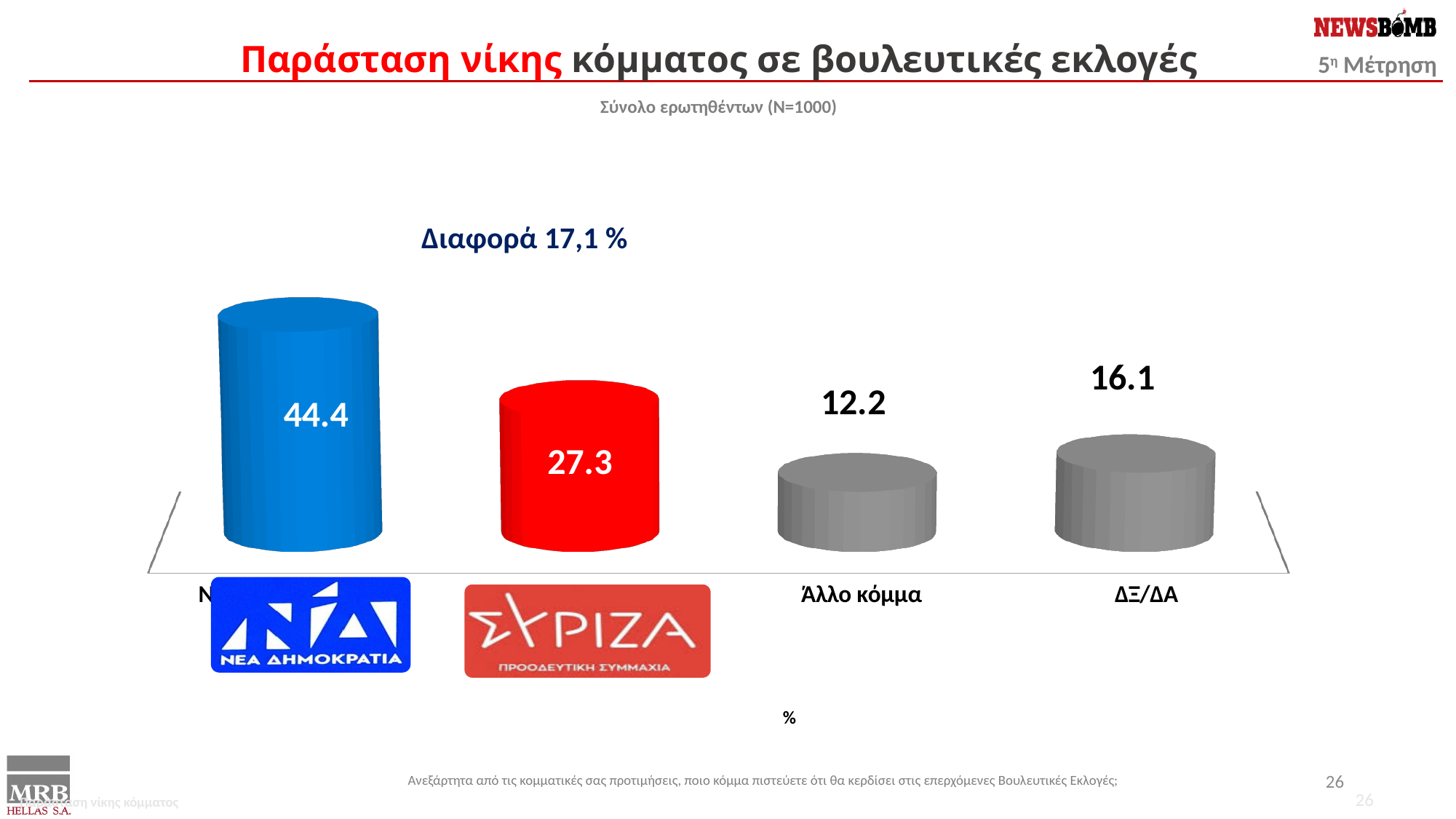
What value is shown for Νέα Δημοκρατία (ΝΔ)? 44.4 What is the difference between the values for ΔΞ/ΔΑ and Άλλο κόμμα? 3.9 Which category has the highest value? Νέα Δημοκρατία (ΝΔ) What difference is stated in the annotation above the chart? Διαφορά 17,1 % Which is larger, the value for ΔΞ/ΔΑ or the value for Άλλο κόμμα? ΔΞ/ΔΑ What value is shown for ΣΥΡΙΖΑ? 27.3 What value is shown for ΔΞ/ΔΑ? 16.1 What kind of chart is shown on the slide? Bar chart What is the difference between the values for Νέα Δημοκρατία and ΣΥΡΙΖΑ? 17.1 How many categories are shown in the chart? 4 What value is shown for Άλλο κόμμα? 12.2 Which category has the lowest value? Άλλο κόμμα